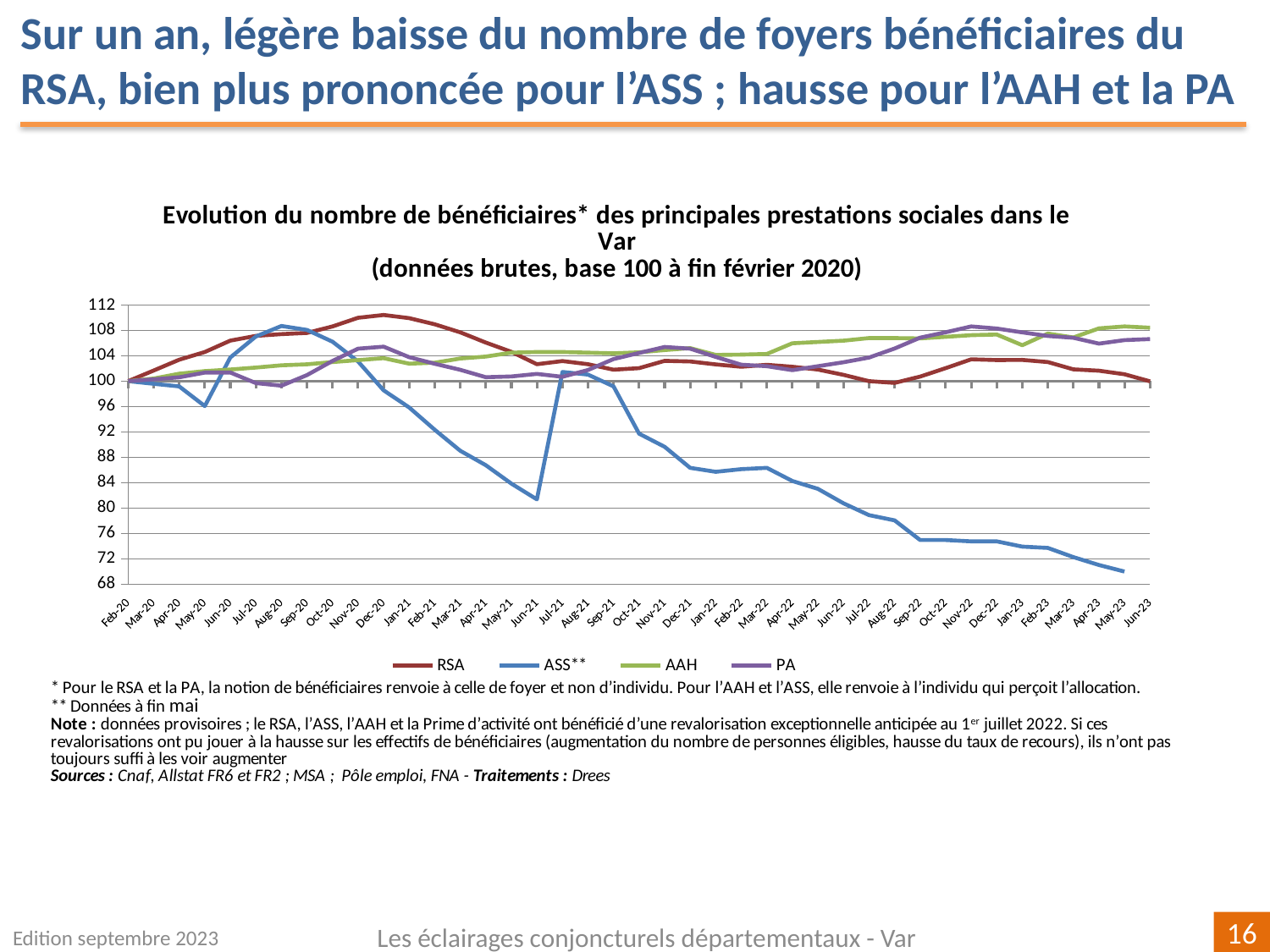
Is the value for ASS** in Jun-21 greater or less than 84? less Which series has the highest value in Dec-20? RSA Which series has the lowest value in Jun-23? RSA Is the value for RSA in Dec-20 greater or less than 108? greater Does the ASS** series overall rise or fall from Feb-20 to Jun-23? fall What kind of chart is shown on the slide? line chart Which series are listed in the legend? RSA, ASS**, AAH, PA What is the value of the RSA series in Feb-20? 100 Is the value for AAH in Jun-23 greater or less than 104? greater How many series does the legend list? 4